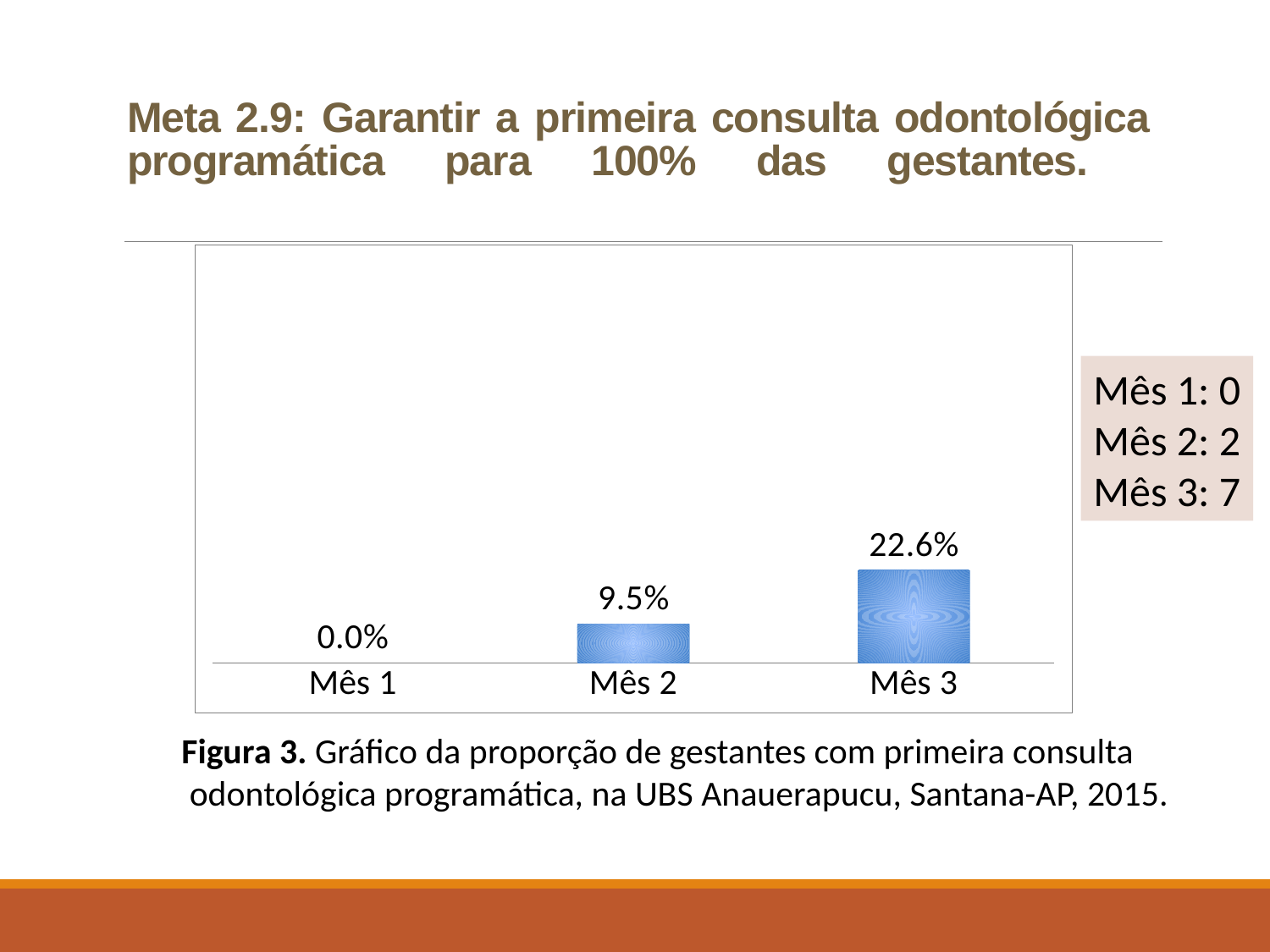
Do the values rise or fall from Mês 1 to Mês 3? Rise What figure number is given in the caption below the chart? Figura 3 What is the value for Mês 3? 22.6% What is the value for Mês 1? 0.0% What kind of chart is shown on the slide? Bar chart Which month has the lowest value? Mês 1 What is the difference between the values for Mês 3 and Mês 2? 13.1% Which is larger, the value for Mês 2 or the value for Mês 3? Mês 3 What is the value for Mês 2? 9.5% Which month has the highest value? Mês 3 How many months are shown on the x axis? 3 According to the text box beside the chart, how many pregnant women does Mês 3 correspond to? 7